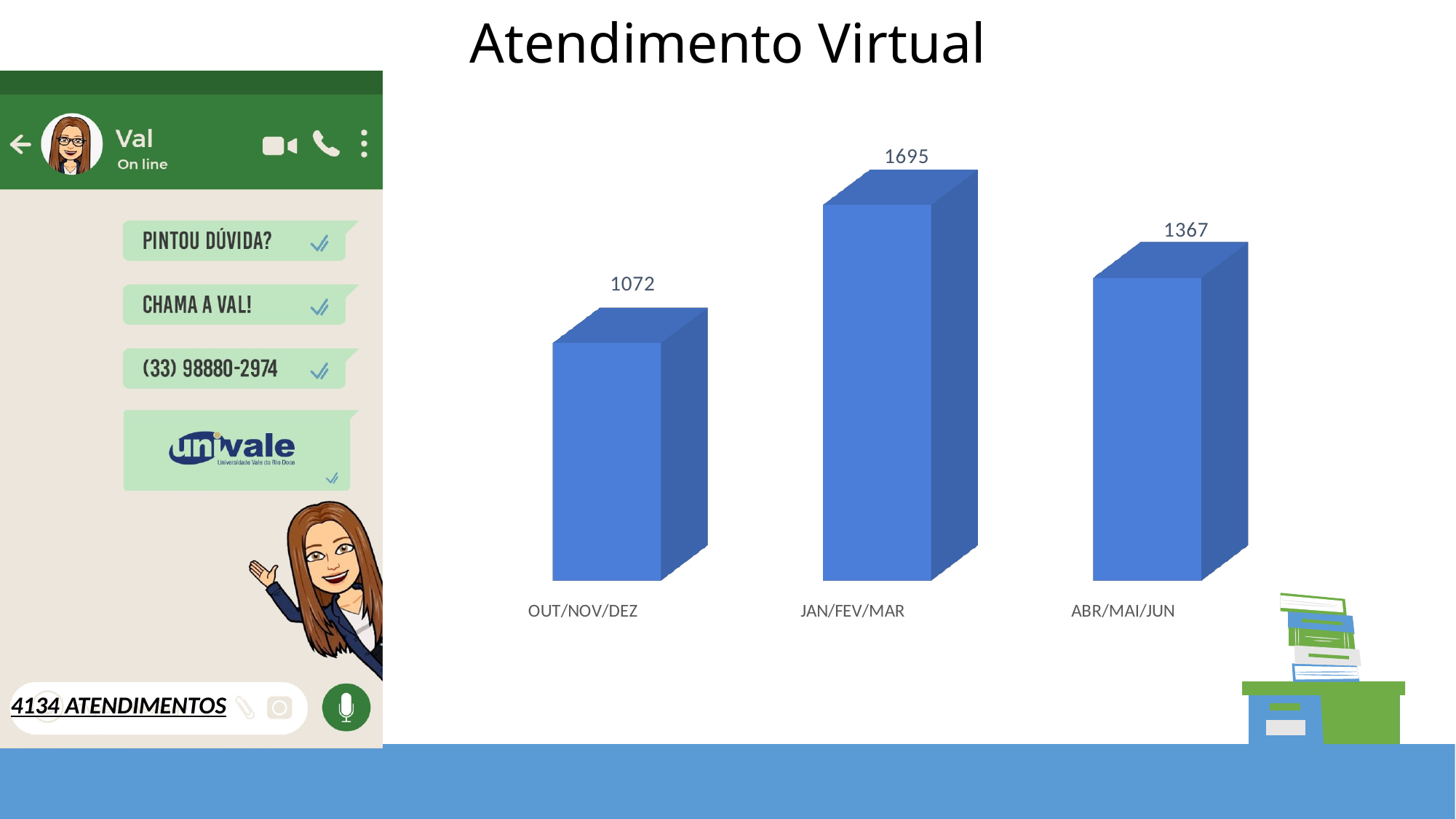
What is the title of the slide containing the chart? Atendimento Virtual What is the value for OUT/NOV/DEZ? 1072 Which category has the highest value? JAN/FEV/MAR What kind of chart is shown on the slide? bar chart What is the difference between the values for JAN/FEV/MAR and ABR/MAI/JUN? 328 What is the value for JAN/FEV/MAR? 1695 What is the difference between the values for JAN/FEV/MAR and OUT/NOV/DEZ? 623 Which is larger, the value for ABR/MAI/JUN or the value for OUT/NOV/DEZ? ABR/MAI/JUN What is the value for ABR/MAI/JUN? 1367 What is the total of the three values shown in the chart? 4134 How many categories are shown in the chart? 3 Which category has the lowest value? OUT/NOV/DEZ